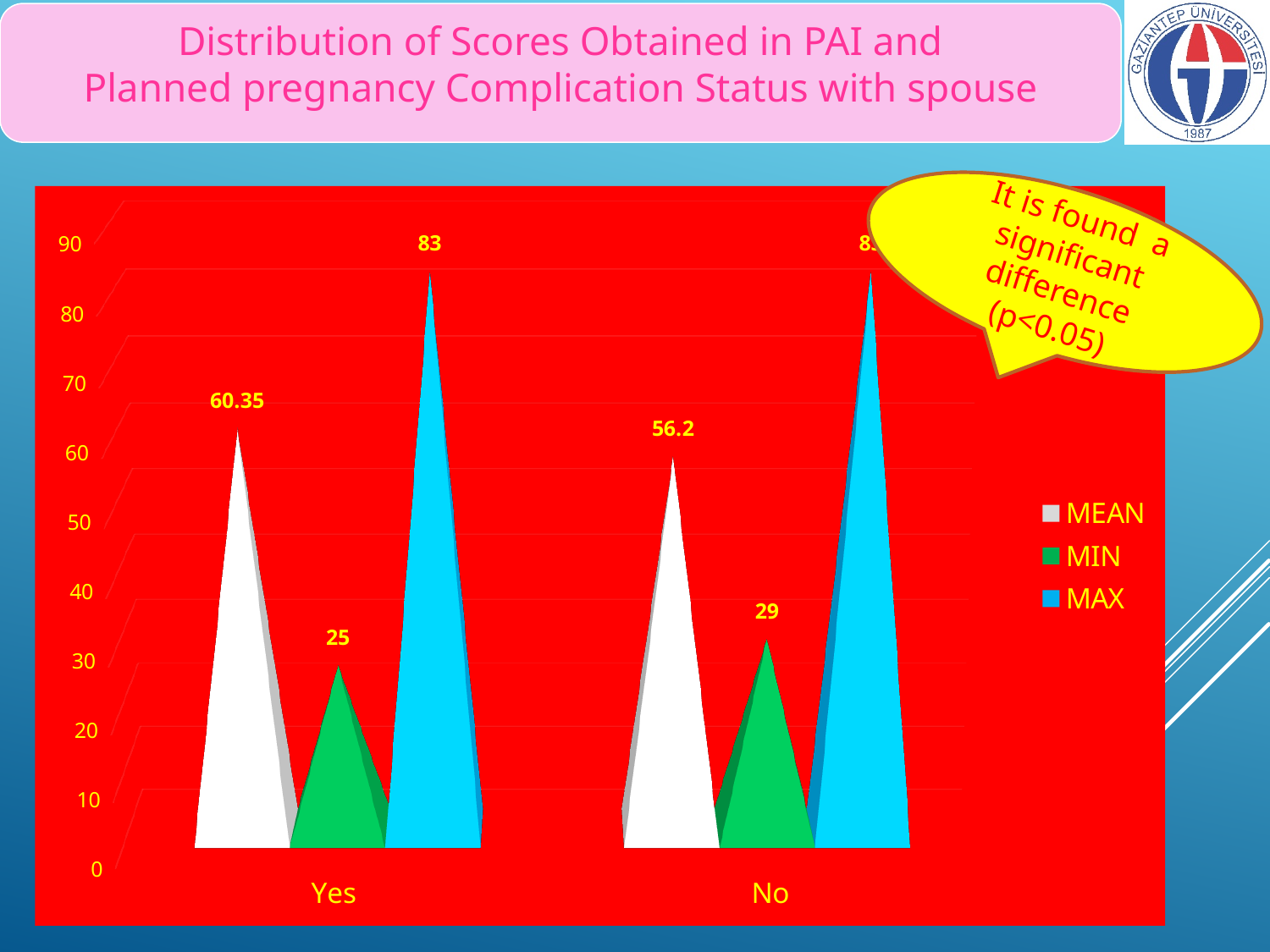
How many categories are shown on the x axis? 2 Which category has the larger MEAN value, Yes or No? Yes Which category has the larger MIN value, Yes or No? No What is the MIN value for the Yes category? 25 How many series does the legend list? 3 What is the MIN value for the No category? 29 Is the MAX value for the No category greater or less than 80? greater What is the difference between the MIN values for No and Yes? 4 What is the MEAN value for the No category? 56.2 What is the difference between the MEAN values for Yes and No? 4.15 What is the MAX value for the Yes category? 83 What is the MEAN value for the Yes category? 60.35